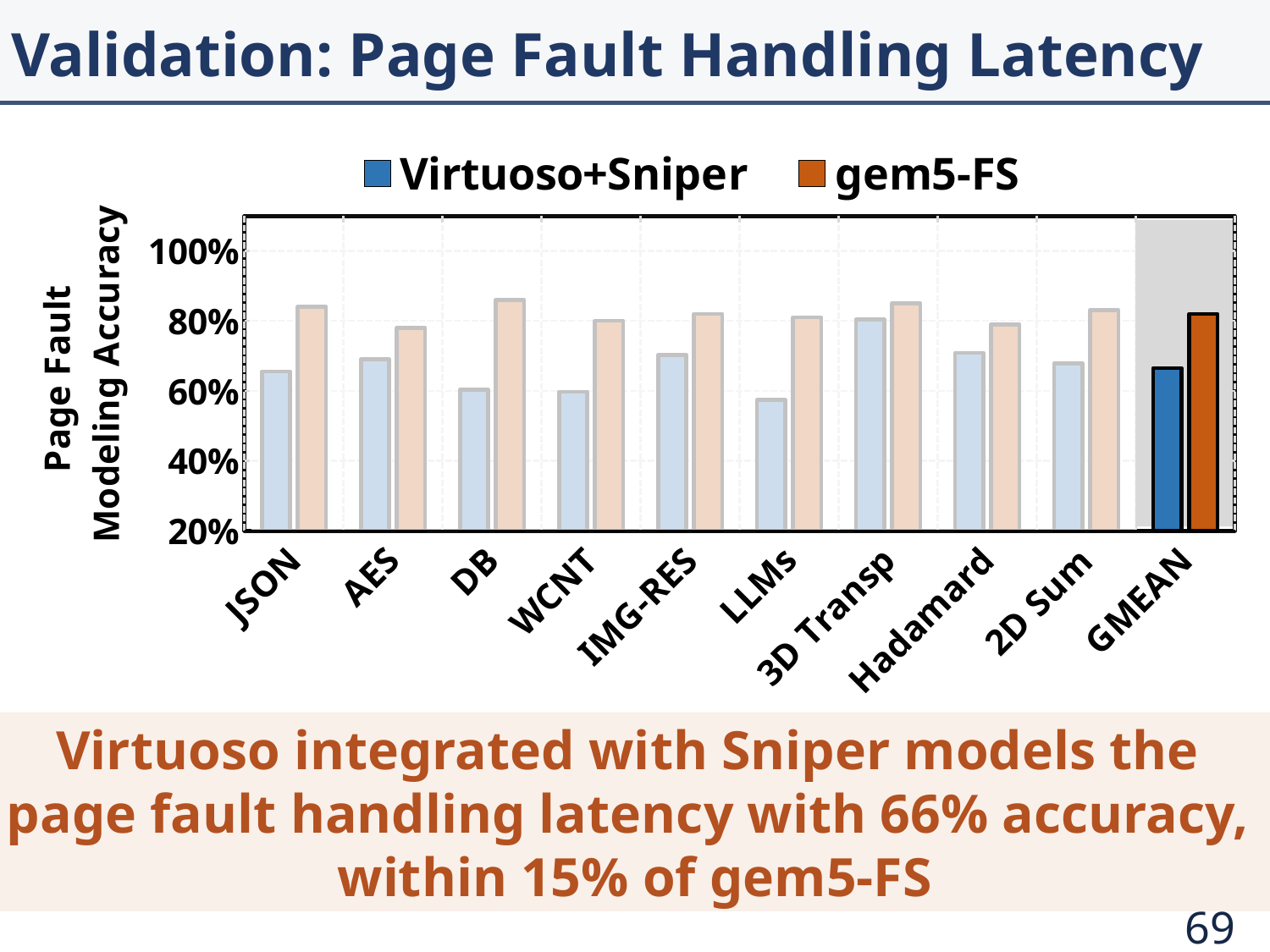
How many series does the legend list? 2 Which series does the legend list first? Virtuoso+Sniper Is the gem5-FS value for 3D Transp greater or less than 80%? greater Which category has the highest Virtuoso+Sniper value? 3D Transp Is the gem5-FS value for DB greater or less than 80%? greater For GMEAN, which series has the larger value, Virtuoso+Sniper or gem5-FS? gem5-FS How many categories are shown on the x axis? 10 Which is larger, the Virtuoso+Sniper value for 3D Transp or the Virtuoso+Sniper value for LLMs? 3D Transp What is the label on the y axis? Page Fault Modeling Accuracy What kind of chart is shown on the slide? bar chart Is the Virtuoso+Sniper value for JSON greater or less than 60%? greater